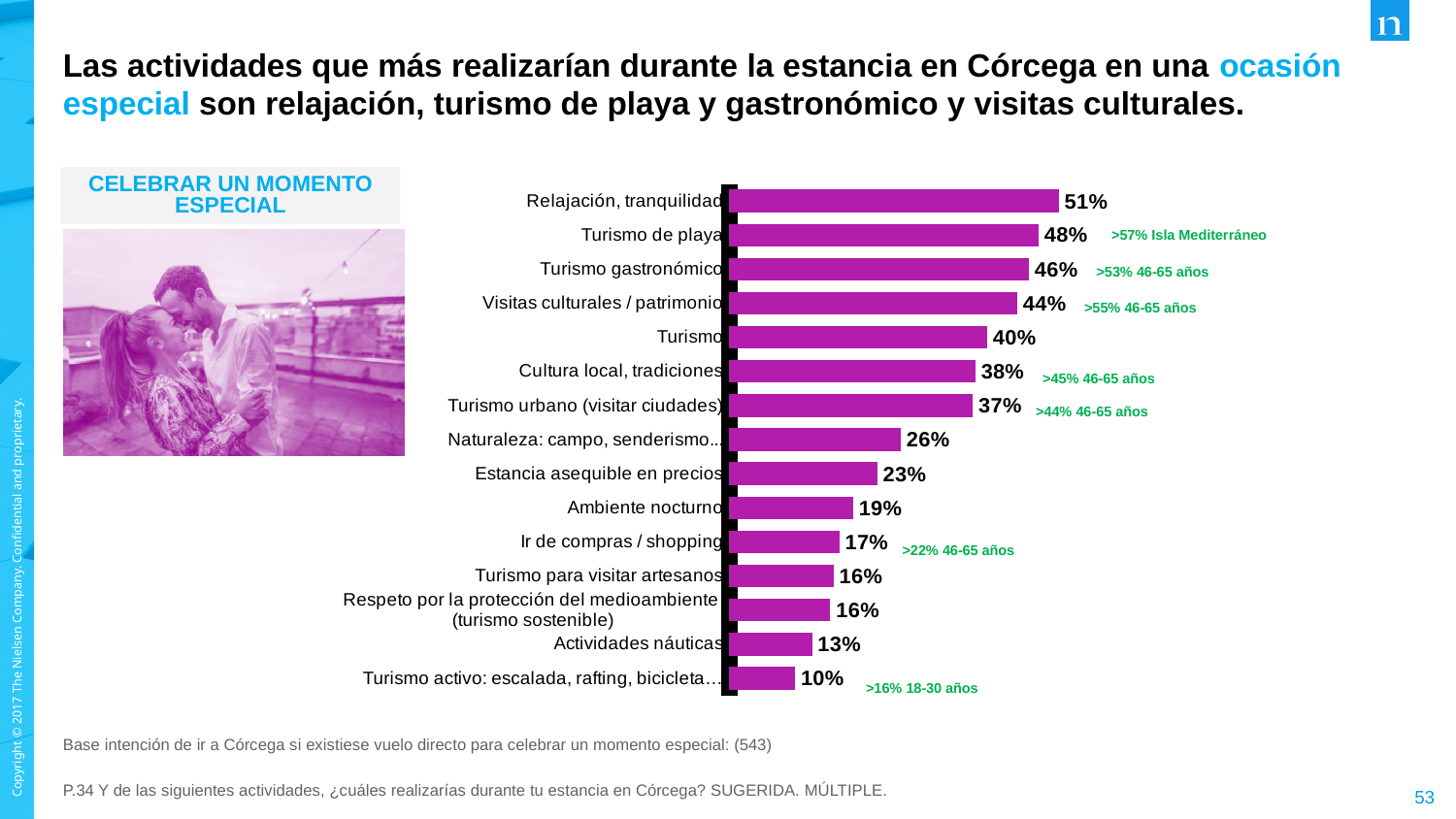
What is the value for "Ambiente nocturno"? 19% How many activities (categories) are shown in the chart? 15 What annotation is printed next to the "Turismo de playa" bar? >57% Isla Mediterráneo Which activity has the lowest value? Turismo activo: escalada, rafting, bicicleta… Which activity has the highest value? Relajación, tranquilidad What is the difference between the values for "Turismo" and "Naturaleza: campo, senderismo..."? 14 percentage points What is the value for "Turismo gastronómico"? 46% Which is larger, the value for "Turismo de playa" or for "Turismo gastronómico"? Turismo de playa What is the value for "Relajación, tranquilidad"? 51% What type of chart is shown on the slide? Bar chart What is the value for "Actividades náuticas"? 13% What is the difference between the values for "Relajación, tranquilidad" and "Turismo de playa"? 3 percentage points